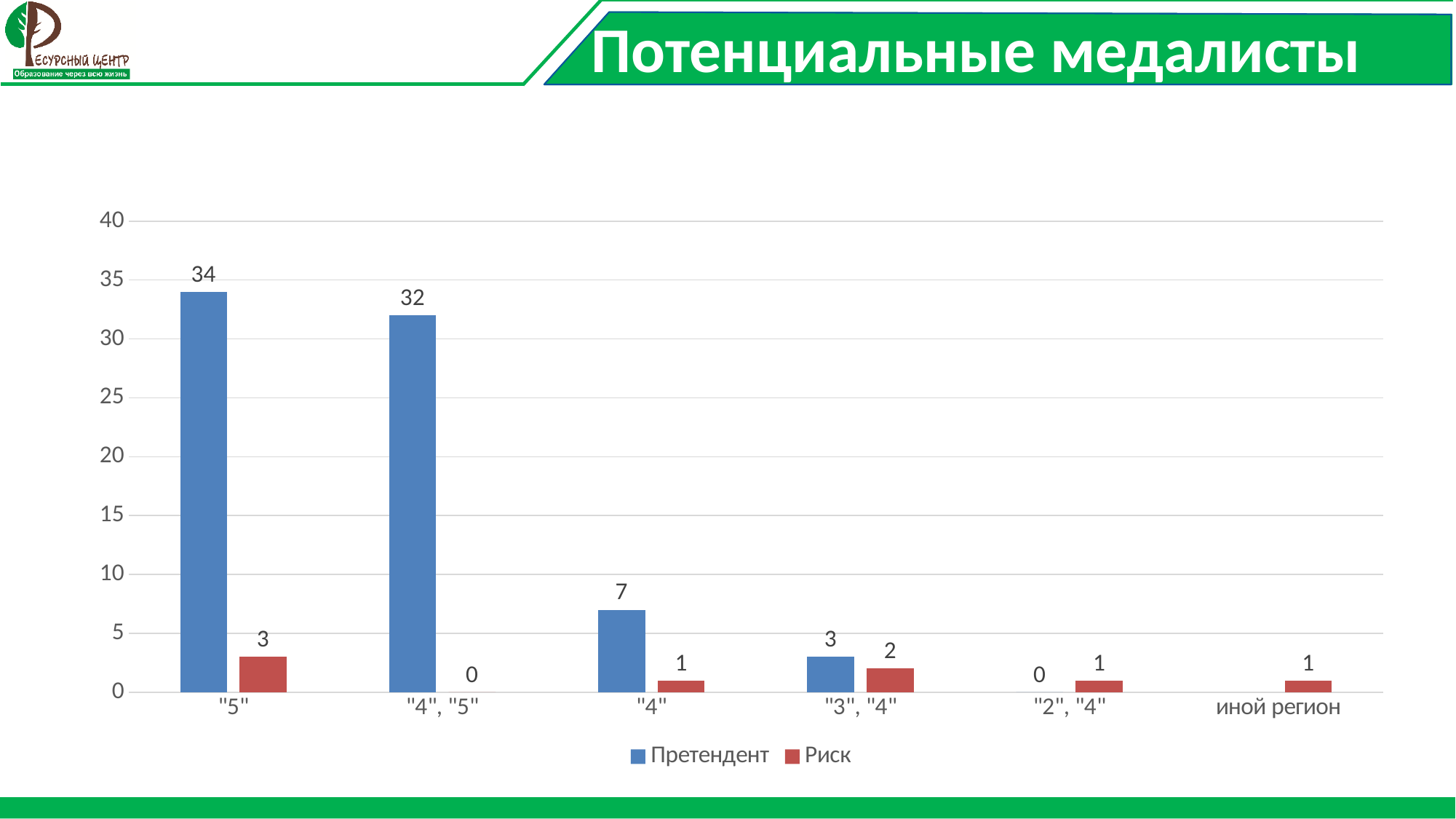
What is the title of the slide containing the chart? Потенциальные медалисты Which category has the highest Риск value? "5" What is the difference between the Претендент values for "5" and "4", "5"? 2 Which is larger: the Претендент value for "3", "4" or the Риск value for "3", "4"? Претендент How many series does the legend list? 2 What is the value of Претендент for the category "5"? 34 How many categories are shown on the x axis? 6 What is the value of Претендент for the category "4"? 7 What is the value of Риск for the category "3", "4"? 2 Which category has the highest Претендент value? "5" What is the value of Риск for the category "4", "5"? 0 What kind of chart is shown on the slide? Bar chart